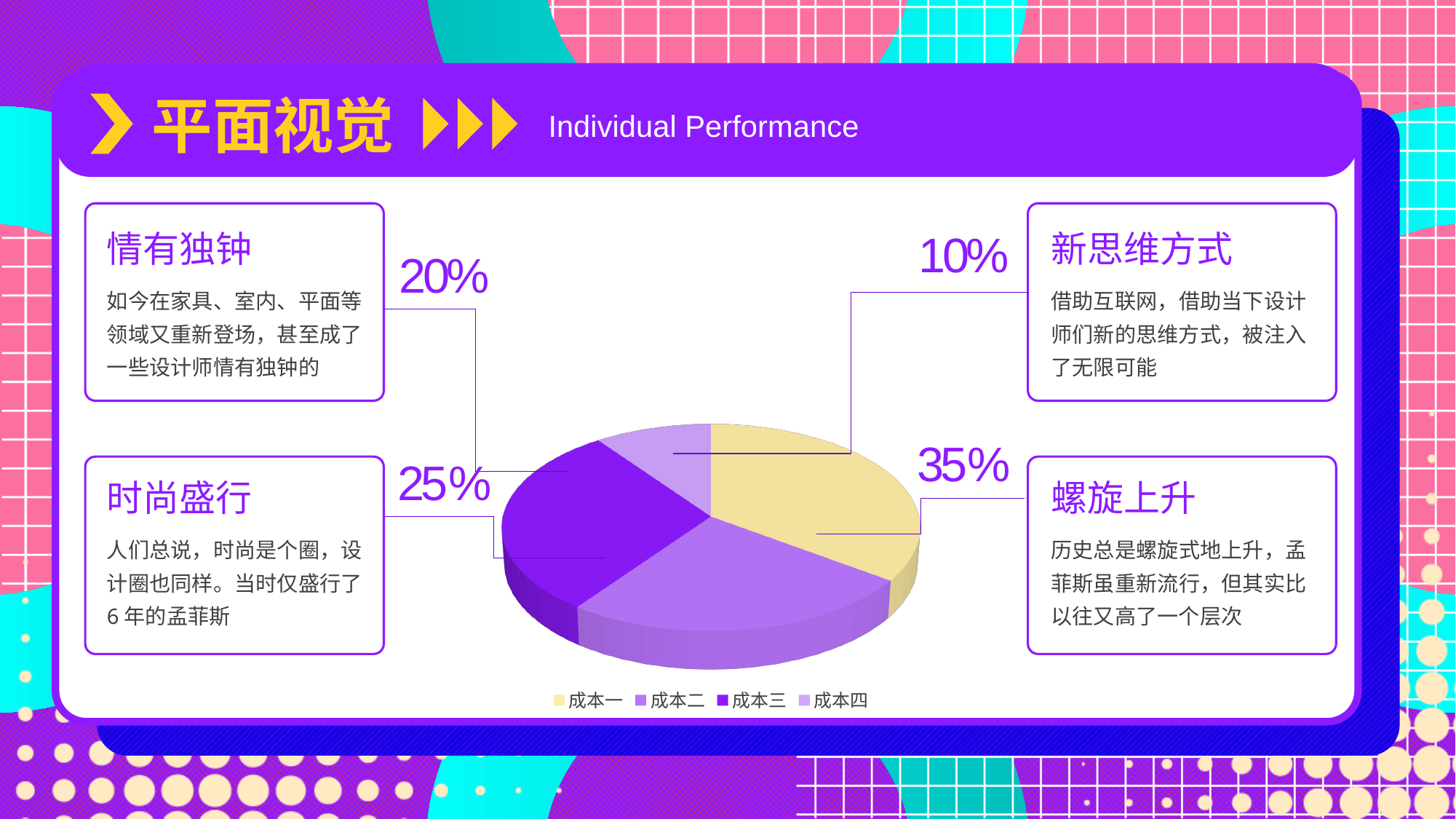
What colour is the 成本一 slice in the pie chart? yellow What are the legend entries of the pie chart, in order? 成本一, 成本二, 成本三, 成本四 How many entries does the pie chart's legend list? 4 Which slice is larger in the pie chart, 成本二 or 成本四? 成本二 Which category has the largest slice in the pie chart? 成本一 Which slice is larger in the pie chart, 成本一 or 成本四? 成本一 Which category has the smallest slice in the pie chart? 成本四 Which slice is larger in the pie chart, 成本三 or 成本四? 成本三 How many slices does the pie chart have? 4 What kind of chart is shown on the slide? pie chart